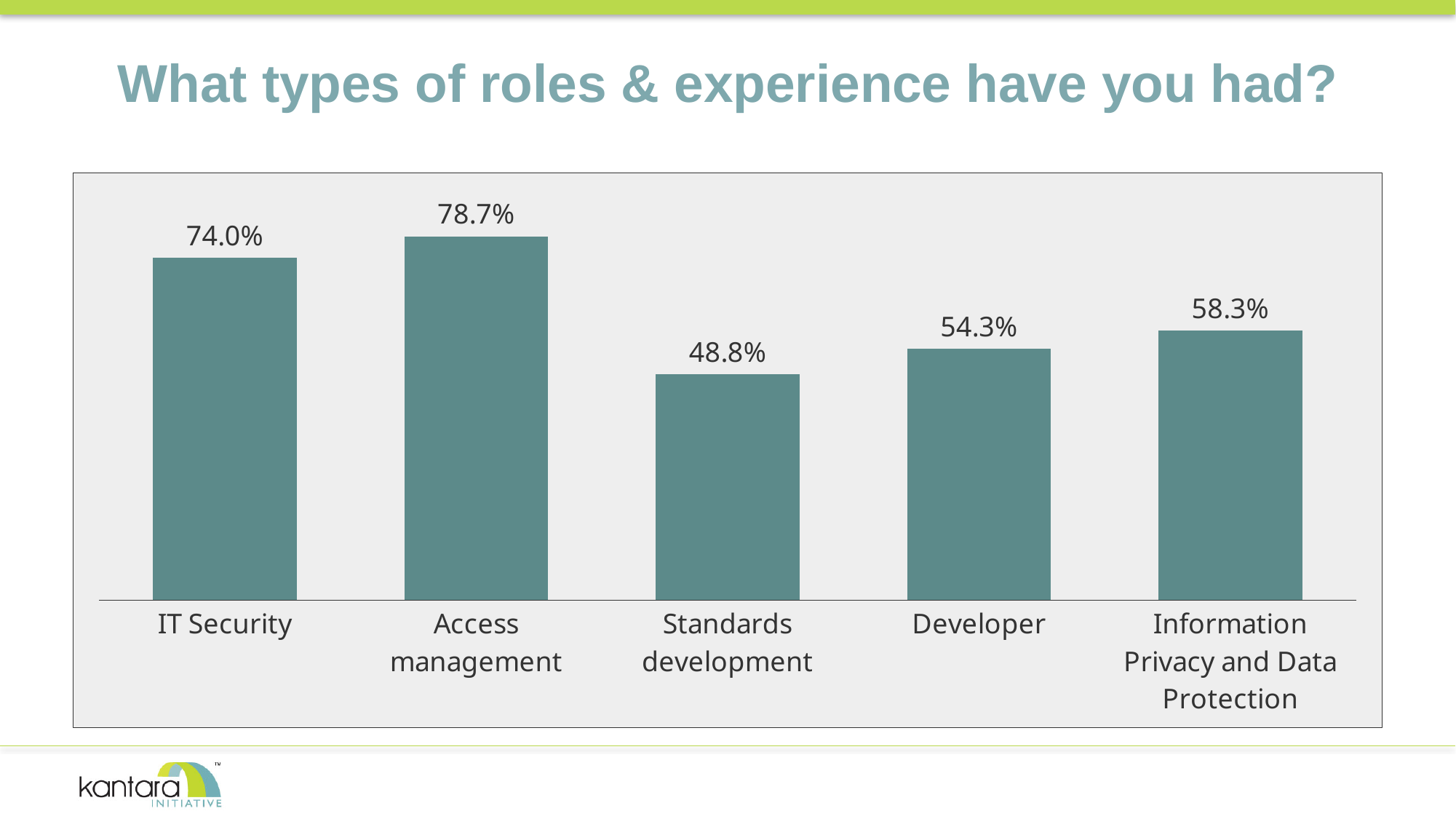
What kind of chart is shown on the slide? Bar chart What is the value for Standards development? 48.8% What is the value for Information Privacy and Data Protection? 58.3% What is the value for Access management? 78.7% What is the value for IT Security? 74.0% How many categories are shown in the chart? 5 What is the value for Developer? 54.3% Which category has the highest value? Access management Which category has the lowest value? Standards development Which is larger, the value for Developer or the value for Information Privacy and Data Protection? Information Privacy and Data Protection What is the difference between the values for Access management and IT Security? 4.7% What is the title of the slide? What types of roles & experience have you had?